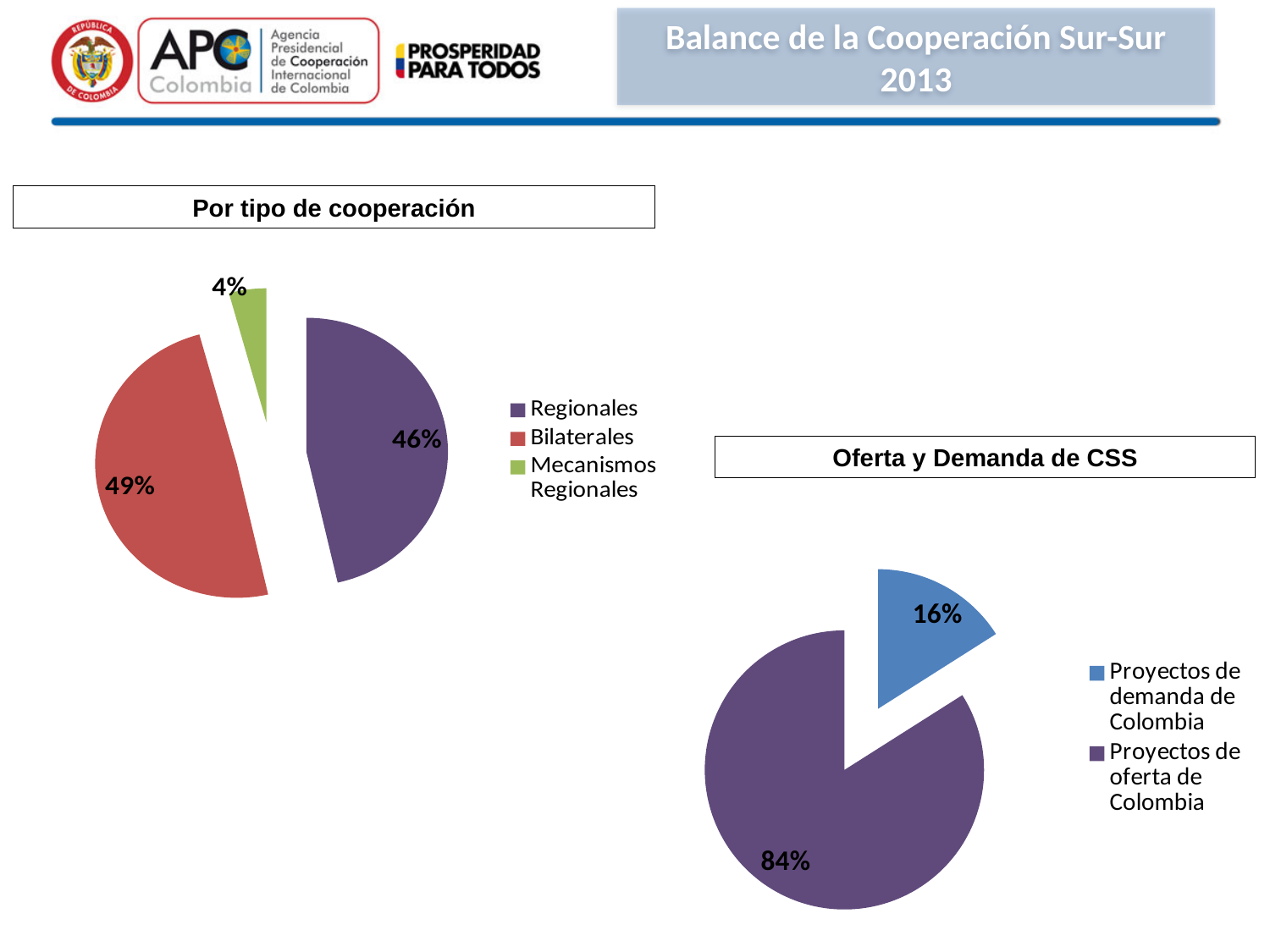
In the 'Por tipo de cooperación' chart, what share does Regionales have? 46% In the 'Por tipo de cooperación' chart, what is the difference in percentage points between Bilaterales and Regionales? 3 In the 'Por tipo de cooperación' chart, what share does Mecanismos Regionales have? 4% What kind of chart is the 'Por tipo de cooperación' chart? Pie chart In the 'Por tipo de cooperación' chart, what share does Bilaterales have? 49% In the 'Oferta y Demanda de CSS' chart, which is larger: Proyectos de demanda de Colombia or Proyectos de oferta de Colombia? Proyectos de oferta de Colombia In the 'Oferta y Demanda de CSS' chart, what share do Proyectos de demanda de Colombia have? 16% In the 'Oferta y Demanda de CSS' chart, how many entries does the legend list? 2 In the 'Por tipo de cooperación' chart, how many categories are shown? 3 In the 'Por tipo de cooperación' chart, which category has the smallest share? Mecanismos Regionales In the 'Oferta y Demanda de CSS' chart, what share do Proyectos de oferta de Colombia have? 84% In the 'Por tipo de cooperación' chart, which category has the largest share? Bilaterales